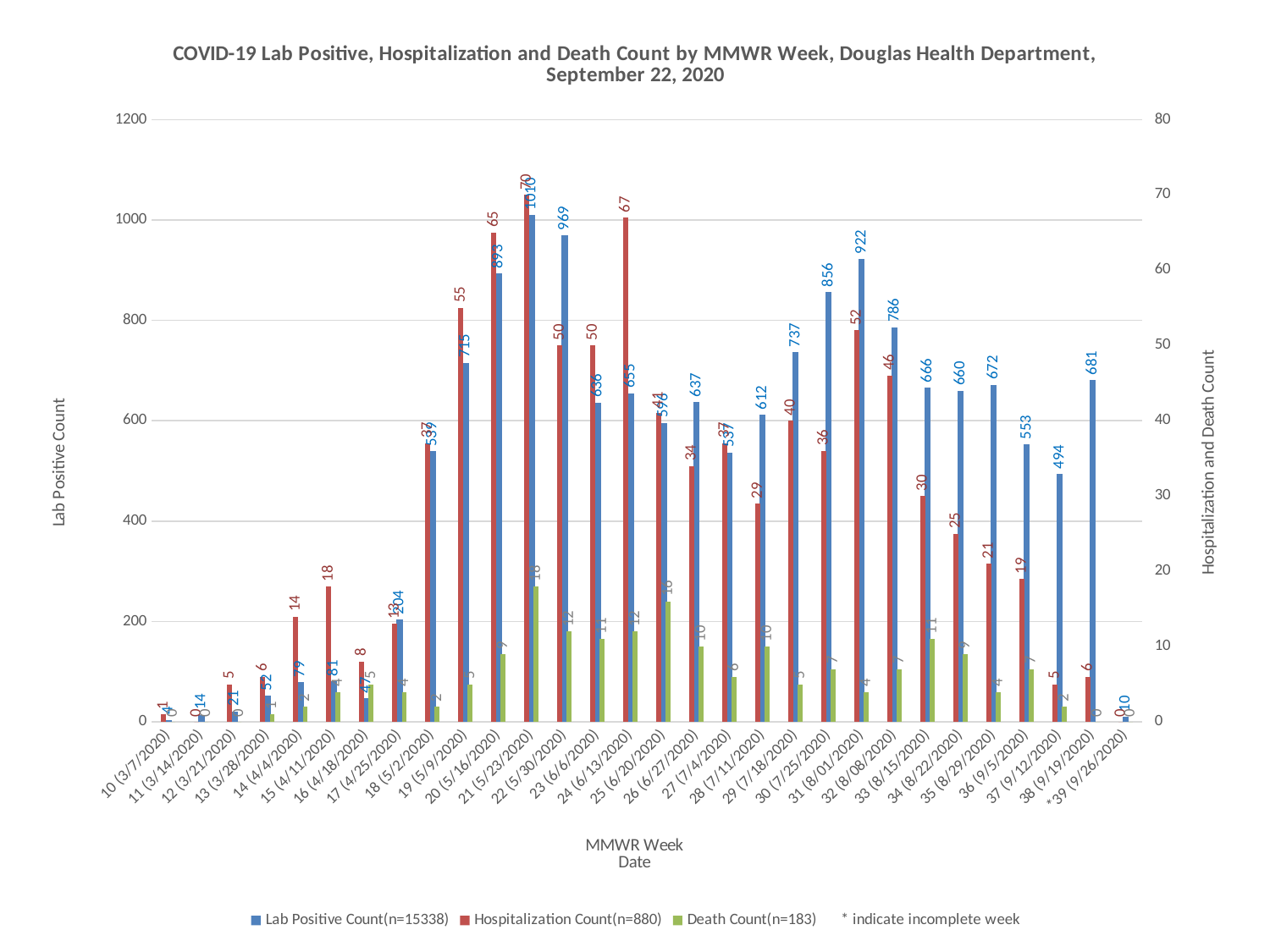
How many series does the legend list? 3 What is the Lab Positive Count for MMWR week 37 (9/12/2020)? 494 Which MMWR week has the highest Hospitalization Count? 21 (5/23/2020) What is the Lab Positive Count for MMWR week 31 (8/01/2020)? 922 How many MMWR weeks are shown on the x axis? 30 Is the Lab Positive Count for week 38 (9/19/2020) greater or less than 600? greater Which MMWR week has the highest Lab Positive Count? 21 (5/23/2020) What kind of chart is shown on the slide? bar chart What is the Hospitalization Count for MMWR week 24 (6/13/2020)? 67 What does the asterisk (*) next to week 39 indicate, according to the legend note? incomplete week What is the difference between the Lab Positive Count in week 21 (5/23/2020) and week 22 (5/30/2020)? 41 Which has the larger Lab Positive Count, week 30 (7/25/2020) or week 32 (8/08/2020)? 30 (7/25/2020)